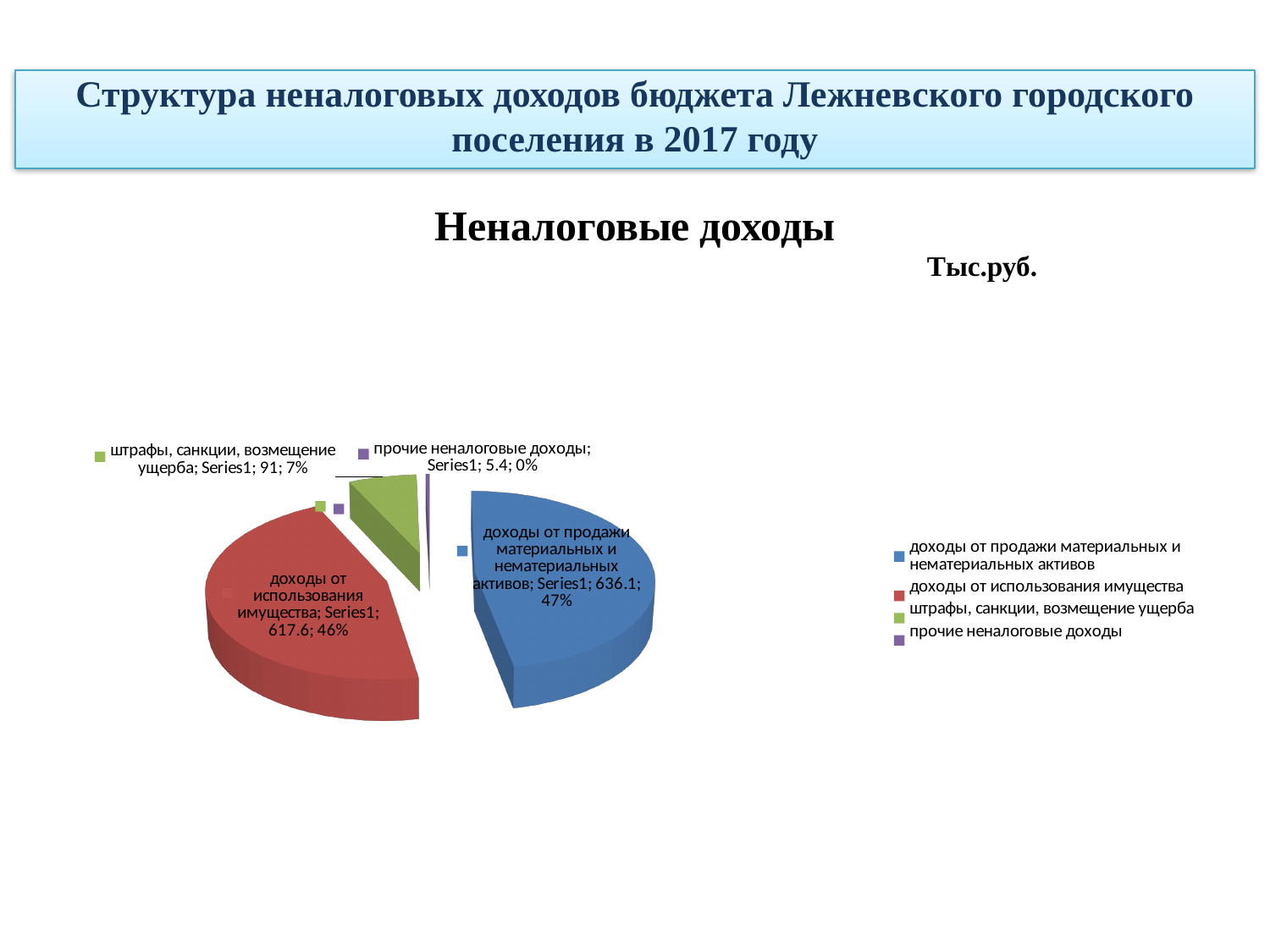
What is the value for доходы от продажи материальных и нематериальных активов? 636.1 What is the value for прочие неналоговые доходы? 5.4 What type of chart is shown on the slide? pie chart What is the value for штрафы, санкции, возмещение ущерба? 91 What is the title of the chart? Неналоговые доходы How many categories does the pie chart have? 4 What share of the pie does доходы от использования имущества represent? 46% What share of the pie does штрафы, санкции, возмещение ущерба represent? 7% What is the difference between the values for доходы от продажи материальных и нематериальных активов and доходы от использования имущества? 18.5 What is the value for доходы от использования имущества? 617.6 Which category has the smallest slice of the pie? прочие неналоговые доходы Which category has the largest slice of the pie? доходы от продажи материальных и нематериальных активов